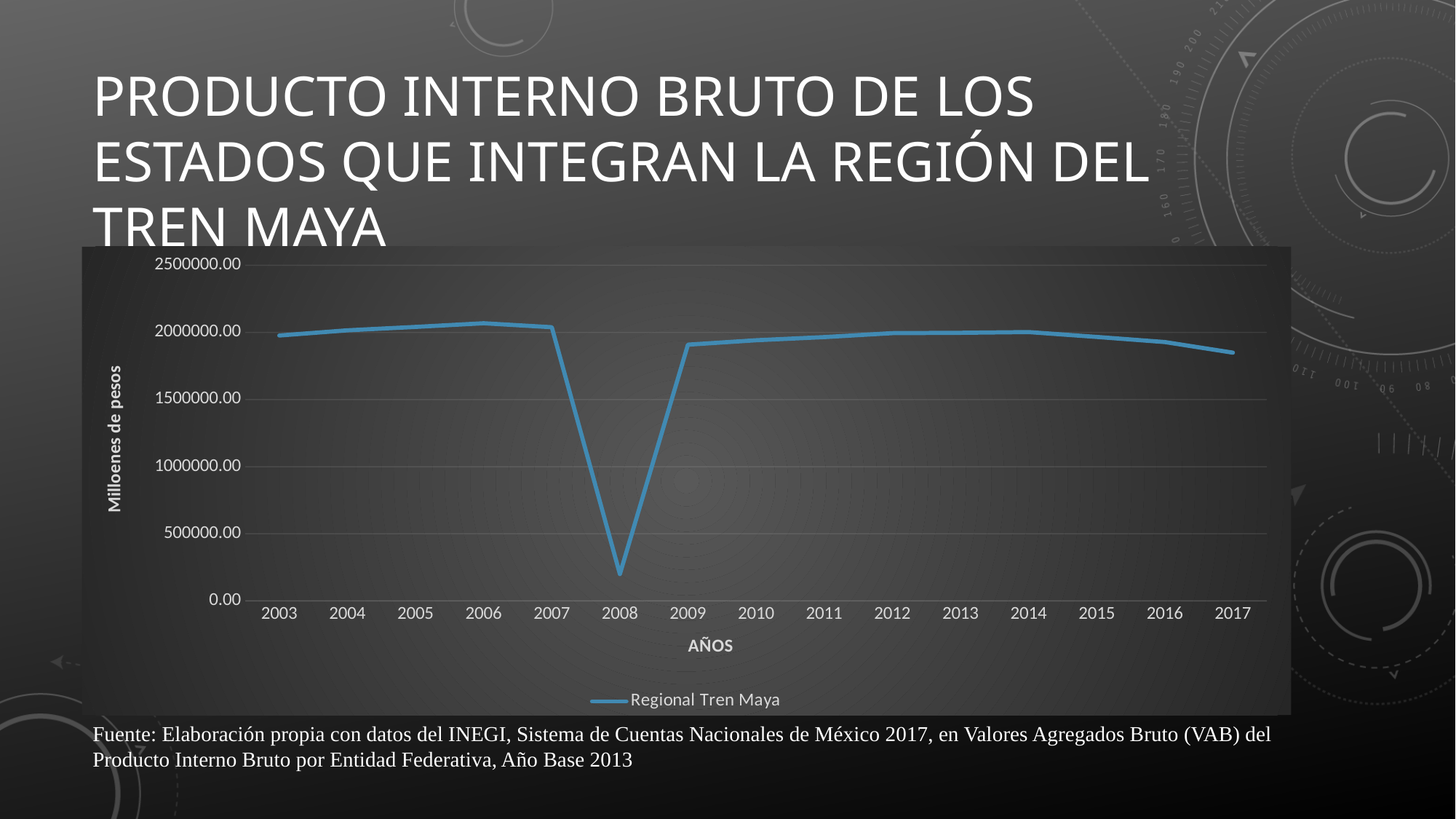
Is the value for 2003 greater or less than 1500000.00? greater Is the value for 2008 greater or less than 500000.00? less How many series does the legend list? 1 Which is larger, the value for 2006 or the value for 2017? 2006 Do the values rise or fall from 2014 to 2017? fall What is the name of the series shown in the legend? Regional Tren Maya What is the title of the x axis? AÑOS Which year has the lowest value for Regional Tren Maya? 2008 Is the value for 2017 greater or less than 2000000.00? less How many years are plotted along the x axis? 15 What kind of chart is shown on the slide? Line chart Which is larger, the value for 2008 or the value for 2009? 2009